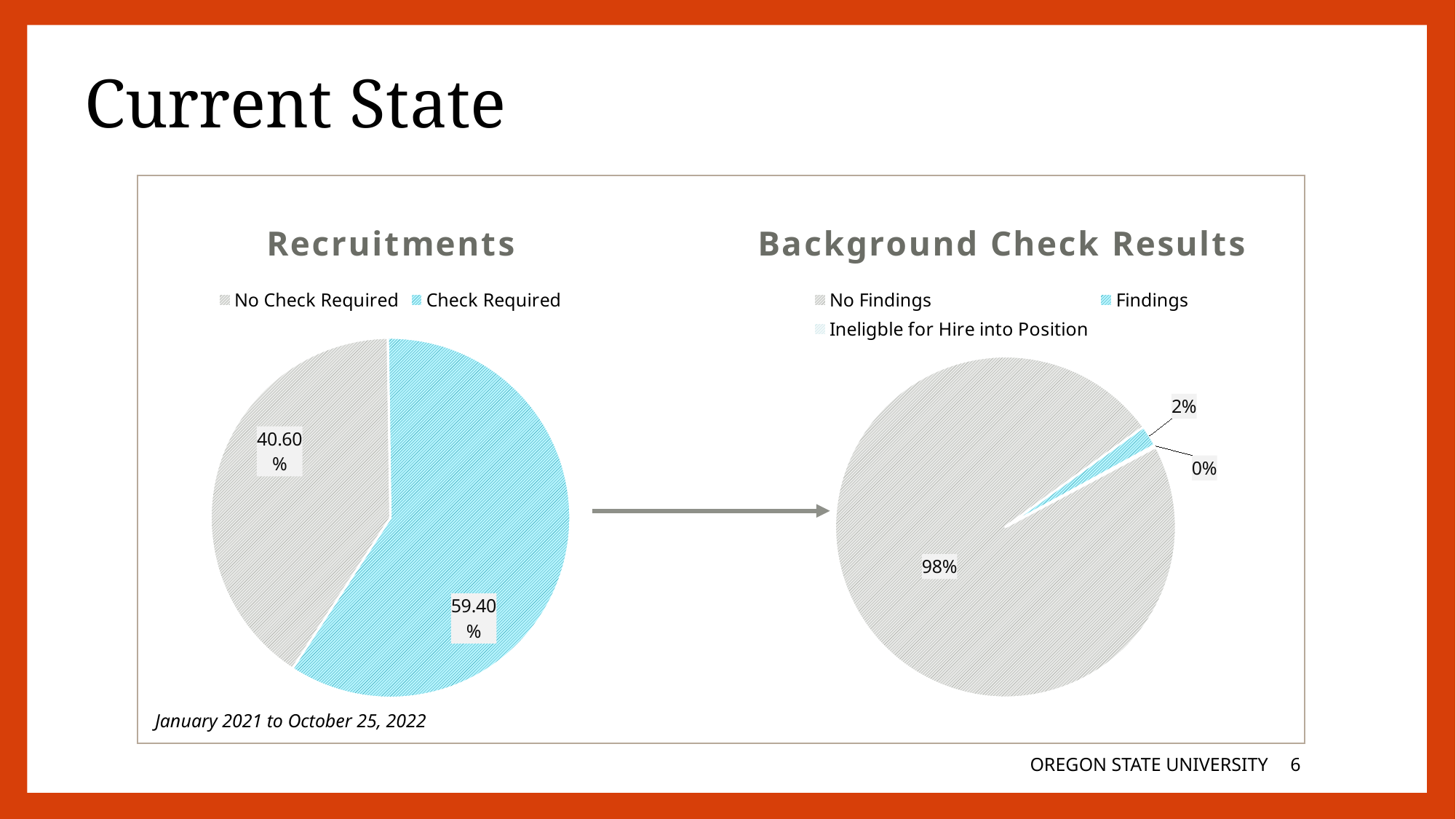
In the Background Check Results chart, what percentage of results had no findings? 98% How many categories does the legend of the Recruitments chart list? 2 In the Background Check Results chart, which category has the smallest share? Ineligble for Hire into Position In the Background Check Results chart, what percentage of results had findings? 2% What date range is noted below the charts? January 2021 to October 25, 2022 What type of chart is the Recruitments chart? Pie chart In the Recruitments chart, which category has the larger share? Check Required In the Recruitments chart, what percentage of recruitments had no check required? 40.60% How many categories does the legend of the Background Check Results chart list? 3 In the Recruitments chart, what percentage of recruitments had a check required? 59.40% In the Background Check Results chart, what percentage is shown for Ineligble for Hire into Position? 0% In the Recruitments chart, what is the difference in percentage points between Check Required and No Check Required? 18.80